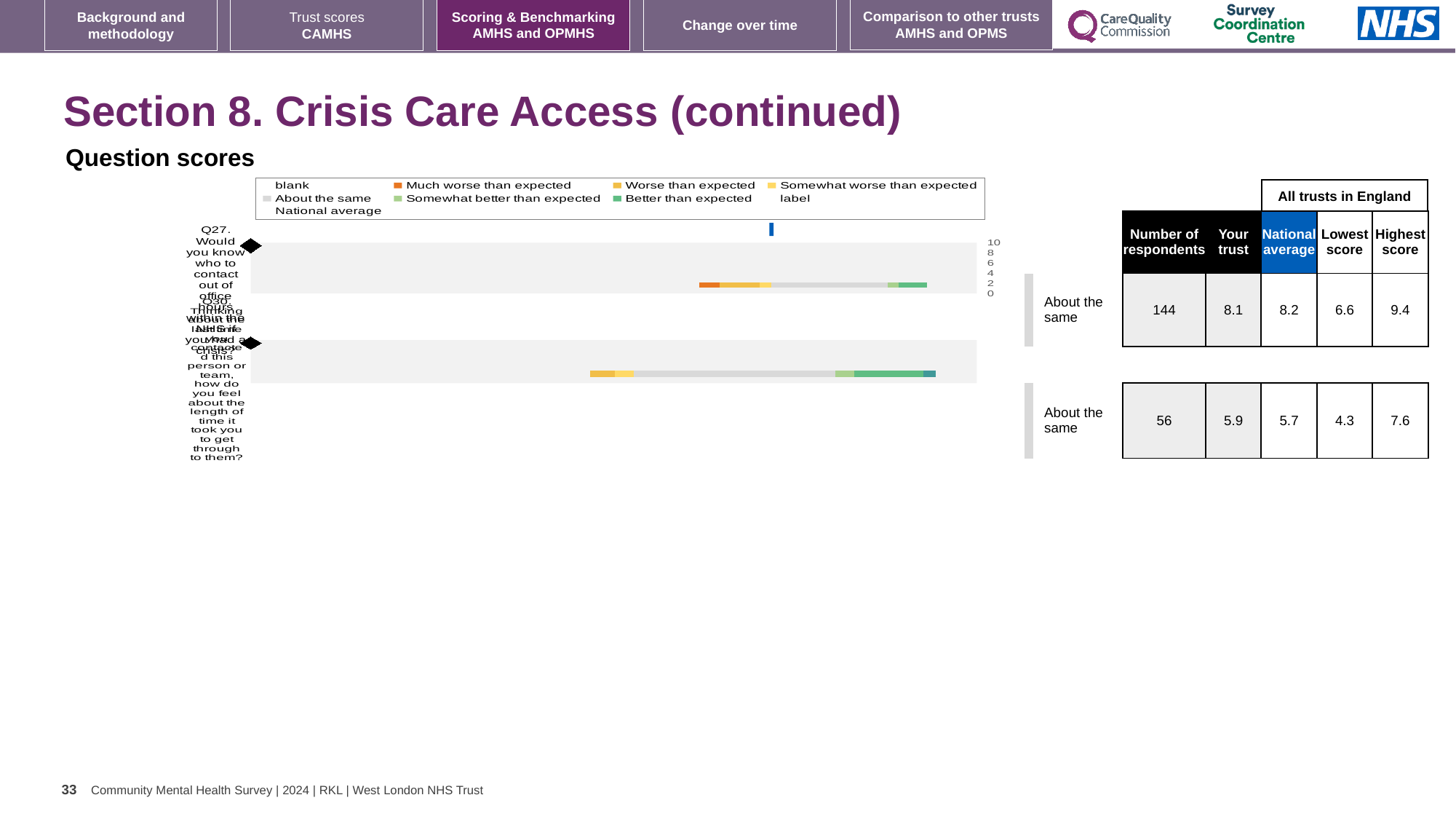
What kind of chart is shown under 'Question scores'? bar chart In the chart legend, what colour is used for 'Much worse than expected'? orange For Q27, which is larger: the 'Your trust' score or the national average? National average In the table beside the chart, what is the highest score among all trusts in England for Q27? 9.4 In the table beside the chart, what is the number of respondents for Q27 (Would you know who to contact out of office hours)? 144 In the table beside the chart, what is the national average for Q27? 8.2 In the table beside the chart, what is the 'Your trust' score for the second question row? 5.9 How many question rows (categories) are plotted in the chart? 2 In the table beside the chart, what is the 'Your trust' score for Q27? 8.1 In the table beside the chart, what is the lowest score among all trusts in England for the second question row? 4.3 For Q27, what is the difference between the highest score (9.4) and the lowest score (6.6)? 2.8